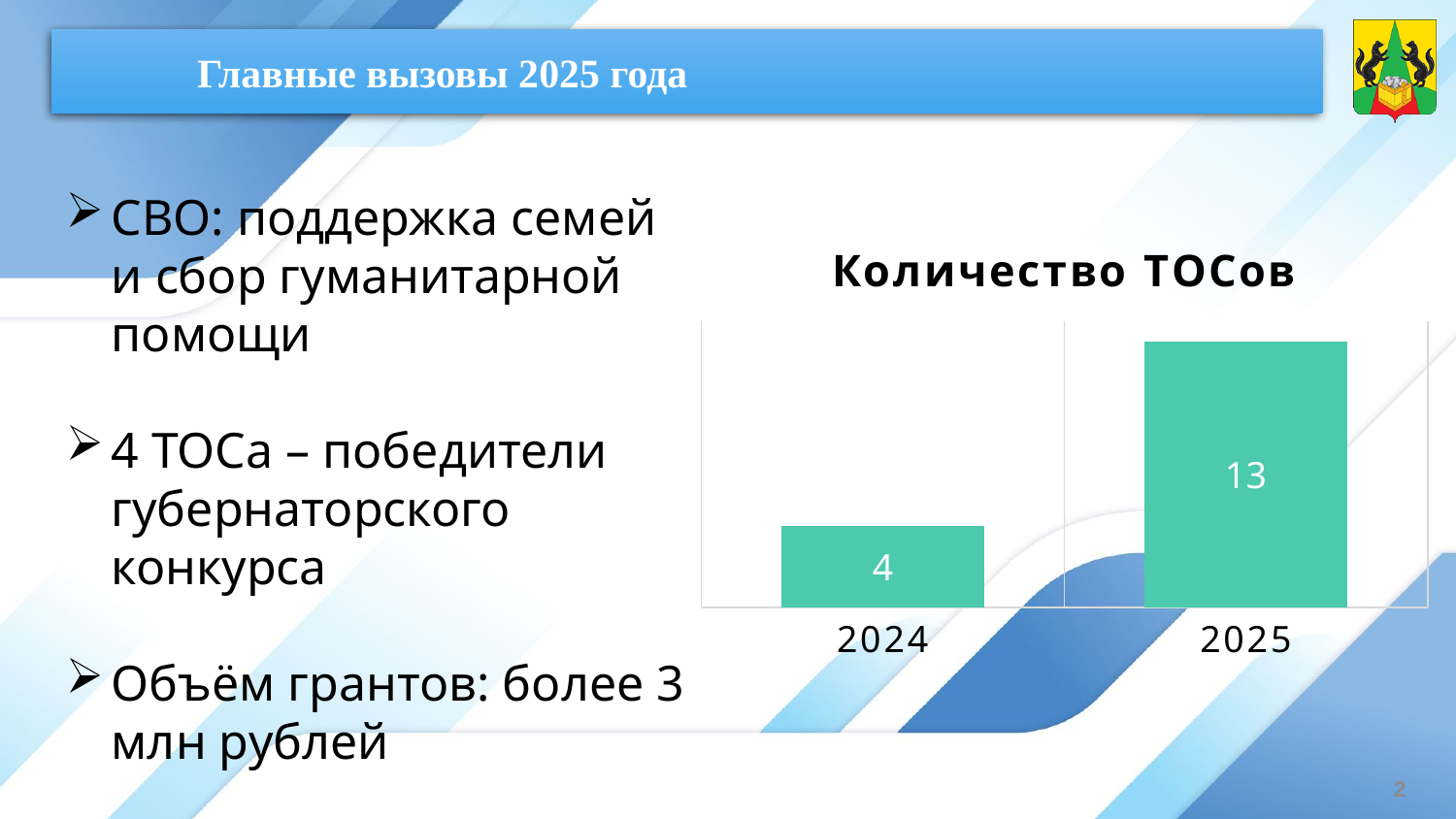
Do the values rise or fall from 2024 to 2025? rise Which year has the highest value in the chart? 2025 What kind of chart is shown on the slide? bar chart What is the value for 2024 in the chart? 4 What is the value for 2025 in the chart? 13 How many categories are shown on the x axis of the chart? 2 What colour are the bars in the chart? green Which year has the lowest value in the chart? 2024 What is the title of the chart? Количество ТОСов Which is larger, the value for 2024 or the value for 2025? 2025 What is the difference between the values for 2025 and 2024? 9